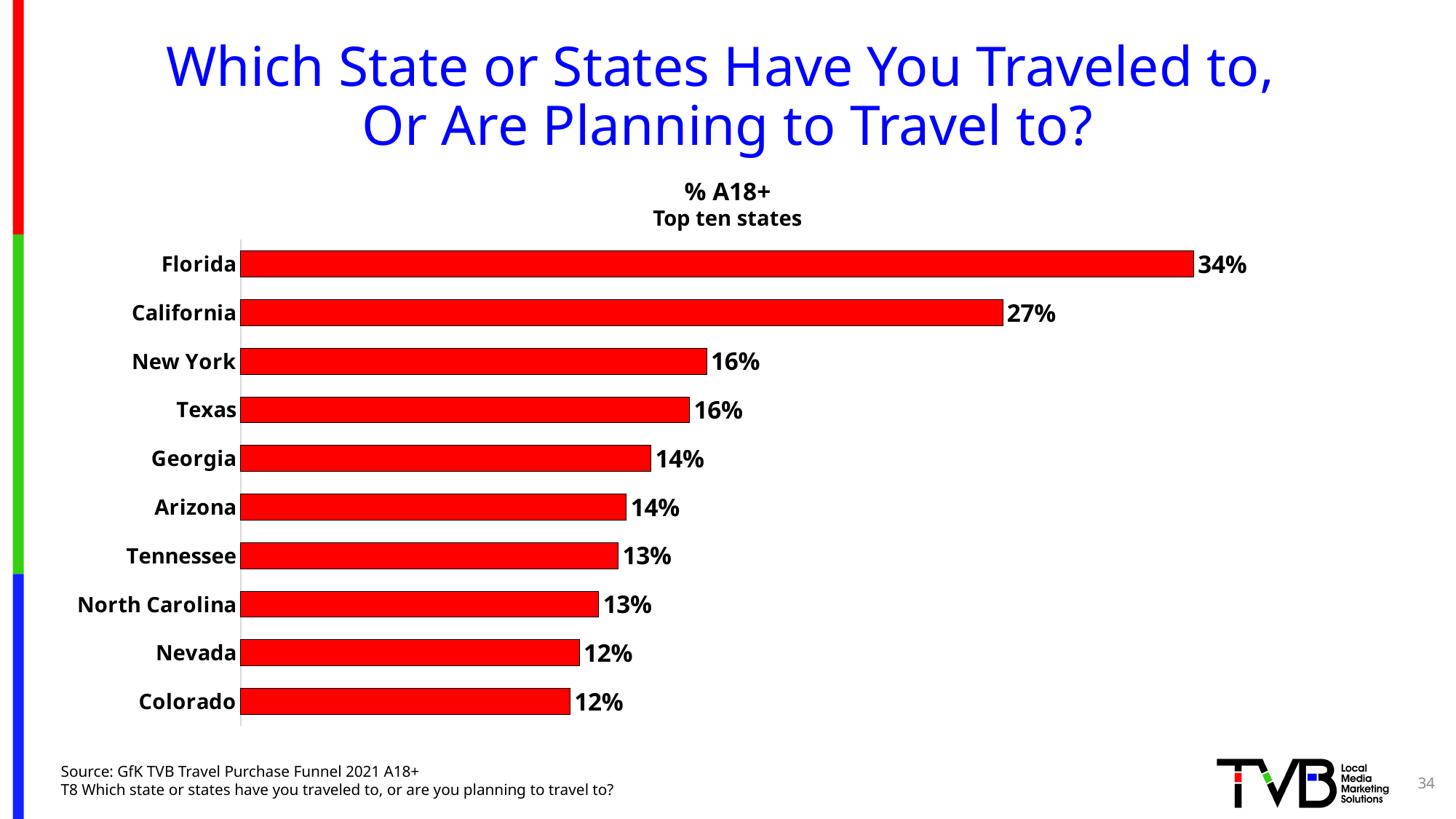
What is the difference in percentage points between Florida and California? 7 How many states are shown on the chart? 10 What is the difference in percentage points between California and New York? 11 Which state has the highest percentage on the chart? Florida What type of chart is shown on the slide? bar chart What is the subtitle printed above the chart? % A18+ Top ten states What is the value shown for Tennessee? 13% What is the value shown for Colorado? 12% Which has a larger value, Texas or North Carolina? Texas What is the value shown for California? 27% What percentage of adults 18+ have traveled to or are planning to travel to Florida? 34% Which has a larger value, Georgia or Nevada? Georgia